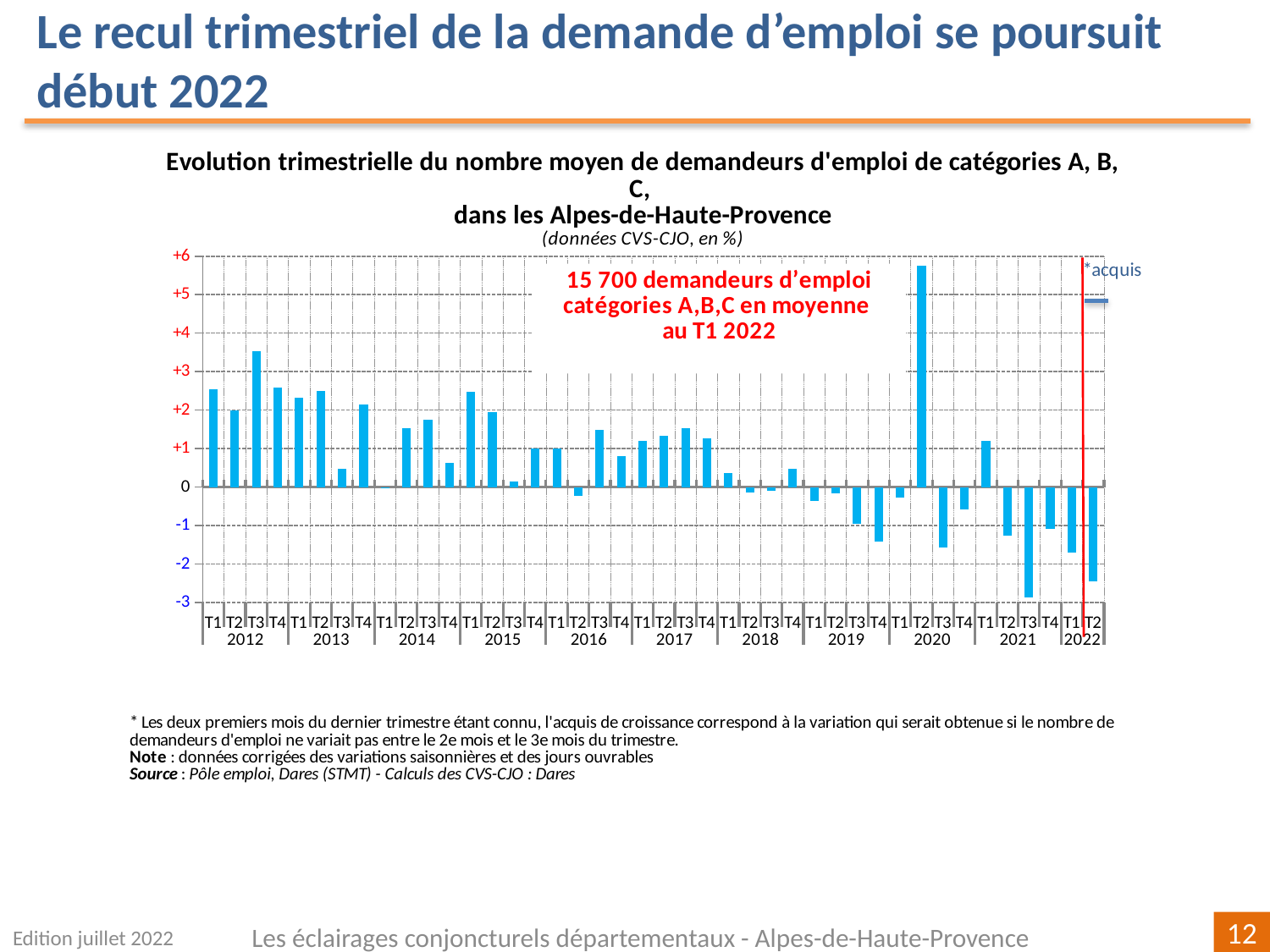
Which quarter has the highest value on the chart? T2 2020 What kind of chart is shown on the slide? Bar chart Is the value for T1 2022 greater or less than -1? less From T1 2021 to T3 2021, do the values rise or fall? fall Which is larger, the value for T3 2012 or the value for T1 2012? T3 2012 Which is larger, the value for T2 2022 or the value for T4 2021? T4 2021 According to the annotation on the chart, how many demandeurs d'emploi catégories A,B,C were there on average in T1 2022? 15 700 How many quarterly bars are plotted on the chart? 42 Which quarter has the lowest value on the chart? T3 2021 Is the value for T3 2021 greater or less than -2? less Is the value for T3 2012 greater or less than +3? greater